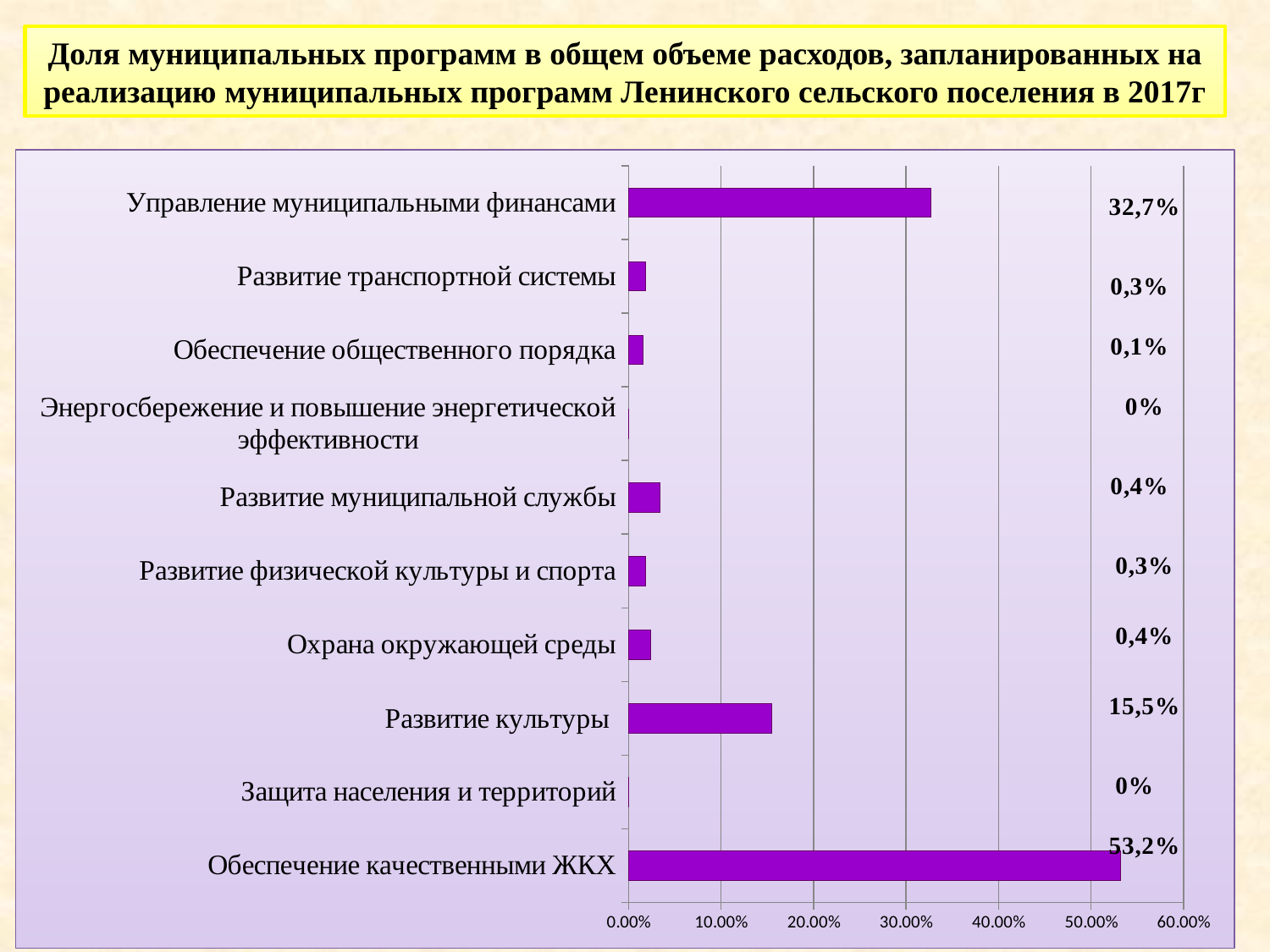
Is the value for Развитие культуры greater or less than 20.00%? less What is the highest tick value shown on the horizontal axis? 60.00% Which is larger, the share for Управление муниципальными финансами or the share for Развитие культуры? Управление муниципальными финансами What is the value shown for Управление муниципальными финансами? 32,7% What is the difference between the shares for Обеспечение качественными ЖКХ and Управление муниципальными финансами? 20,5% What is the value shown for Развитие культуры? 15,5% What kind of chart is shown on the slide? bar chart What is the value shown for Обеспечение качественными ЖКХ? 53,2% Is the value for Обеспечение качественными ЖКХ greater or less than 50.00%? greater Which programme has the highest share? Обеспечение качественными ЖКХ How many categories (municipal programmes) are plotted in the chart? 10